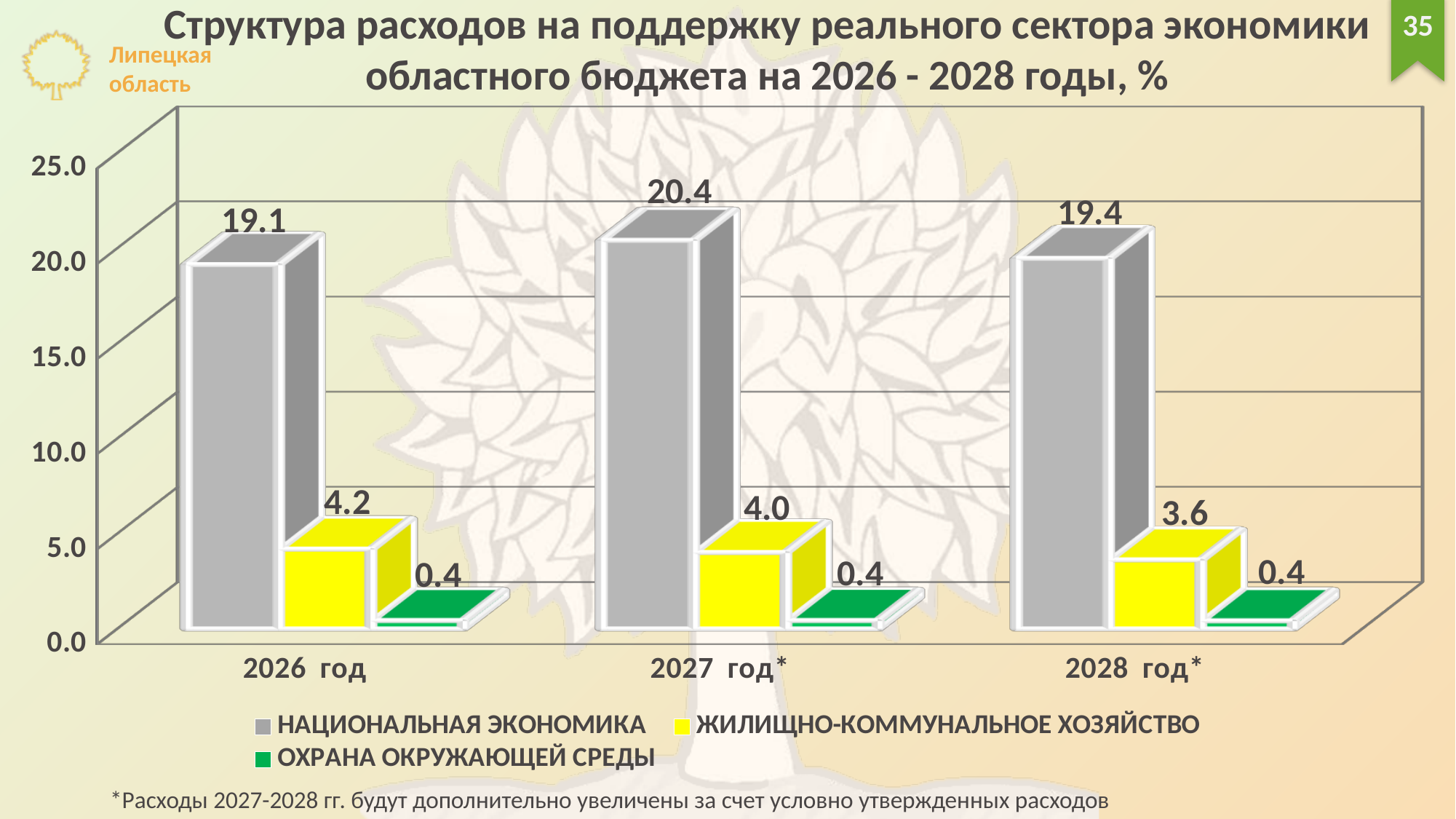
Which is larger: ЖИЛИЩНО-КОММУНАЛЬНОЕ ХОЗЯЙСТВО in 2026 год or in 2027 год*? 2026 год What kind of chart is shown on the slide? bar chart How many series does the legend list? 3 What is the value for ЖИЛИЩНО-КОММУНАЛЬНОЕ ХОЗЯЙСТВО in 2028 год*? 3.6 In which year is the value for ЖИЛИЩНО-КОММУНАЛЬНОЕ ХОЗЯЙСТВО lowest? 2028 год* How many years are shown on the x axis? 3 What is the value for НАЦИОНАЛЬНАЯ ЭКОНОМИКА in 2026 год? 19.1 Does the value for ЖИЛИЩНО-КОММУНАЛЬНОЕ ХОЗЯЙСТВО rise or fall from 2026 год to 2028 год*? fall In which year is the value for НАЦИОНАЛЬНАЯ ЭКОНОМИКА highest? 2027 год* What is the value for ОХРАНА ОКРУЖАЮЩЕЙ СРЕДЫ in 2027 год*? 0.4 What is the difference between the НАЦИОНАЛЬНАЯ ЭКОНОМИКА values for 2027 год* and 2026 год? 1.3 Is the value for НАЦИОНАЛЬНАЯ ЭКОНОМИКА in 2028 год* greater or less than 15.0? greater